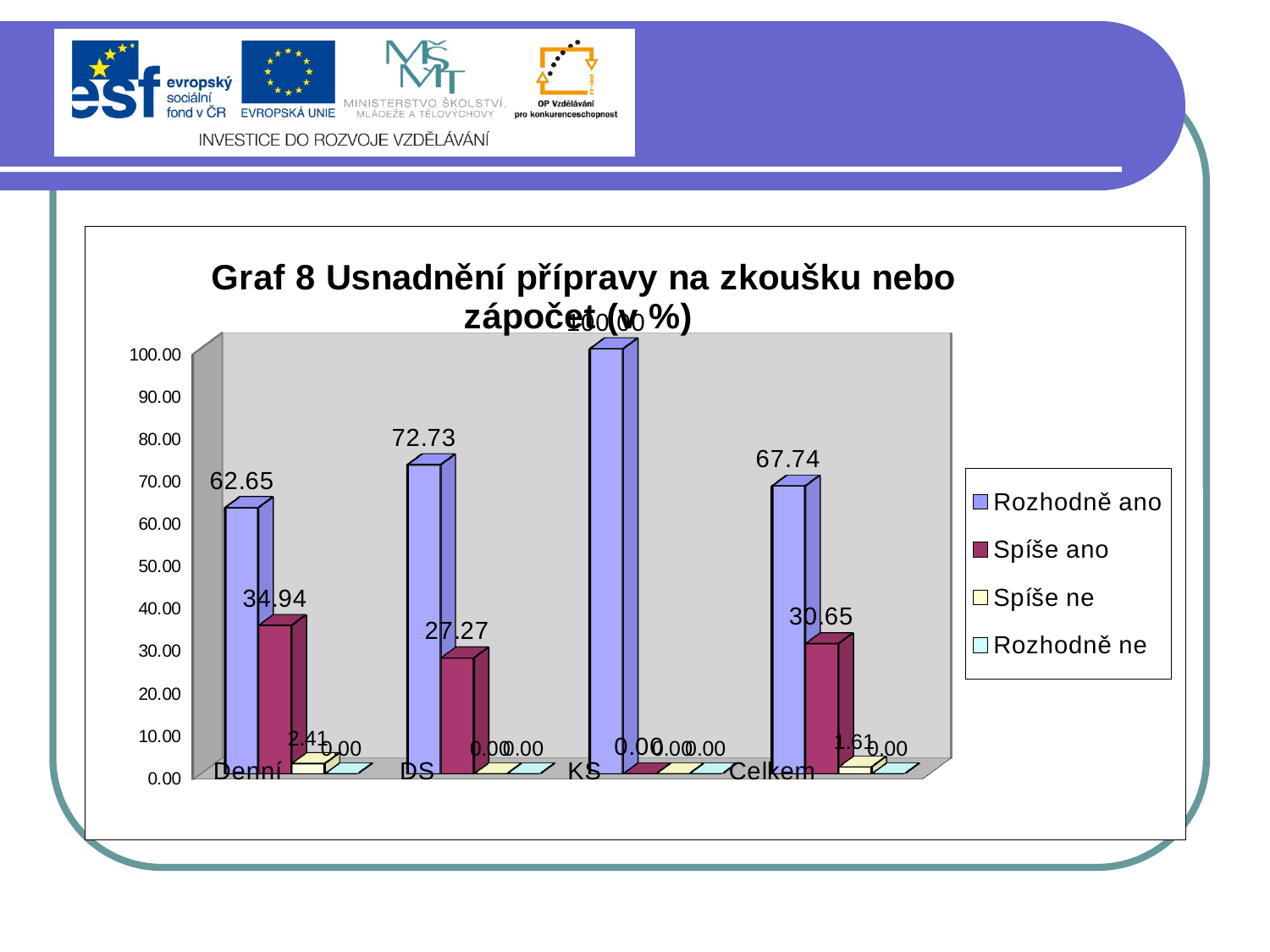
Which category has the larger Spíše ano value, Denní or Celkem? Denní What is the value for Spíše ne in the Celkem category? 1.61 What is the value for Rozhodně ano in the Celkem category? 67.74 What is the value for Spíše ne in the Denní category? 2.41 What is the value for Rozhodně ano in the Denní category? 62.65 How many series does the legend list? 4 What kind of chart is shown on the slide? Bar chart What is the difference between the Rozhodně ano values for DS and Denní? 10.08 How many categories are shown on the x axis? 4 What is the value for Spíše ano in the DS category? 27.27 Which category has the highest value for Rozhodně ano? KS Which category has the lowest value for Rozhodně ano? Denní